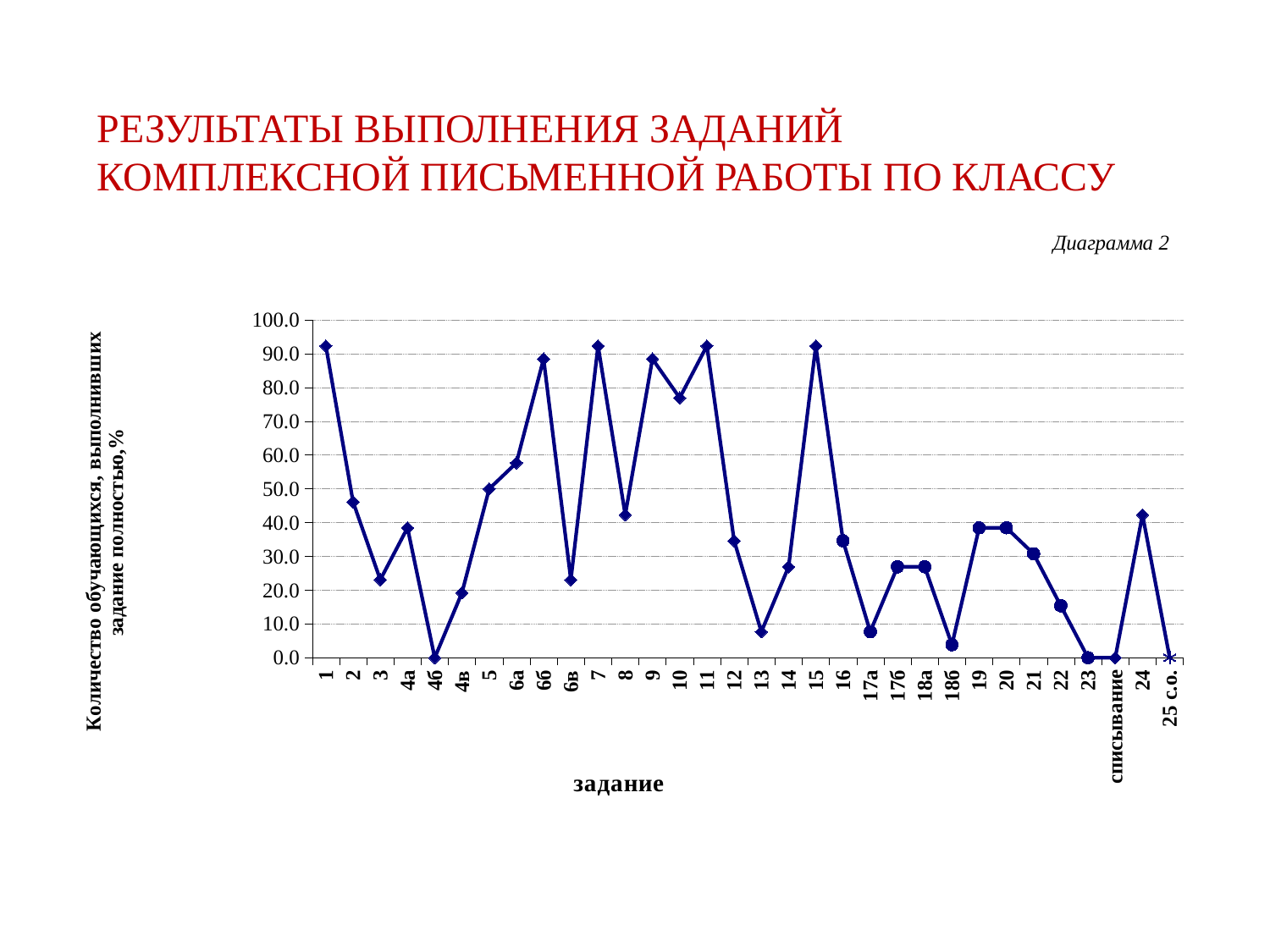
Is the value for task 1 greater or less than 80.0? greater Is the value for task 13 greater or less than 10.0? less What kind of chart is shown on the slide? line chart Which has the larger value, task 1 or task 2? task 1 What is the value for the category 'списывание'? 0.0 What is the value for task 4б? 0.0 Is the value for task 15 greater or less than 80.0? greater How many tasks (categories) are plotted along the x axis? 32 What is the value for task 23? 0.0 What is the label of the x axis? задание Do the values rise or fall from task 19 to task 23? fall